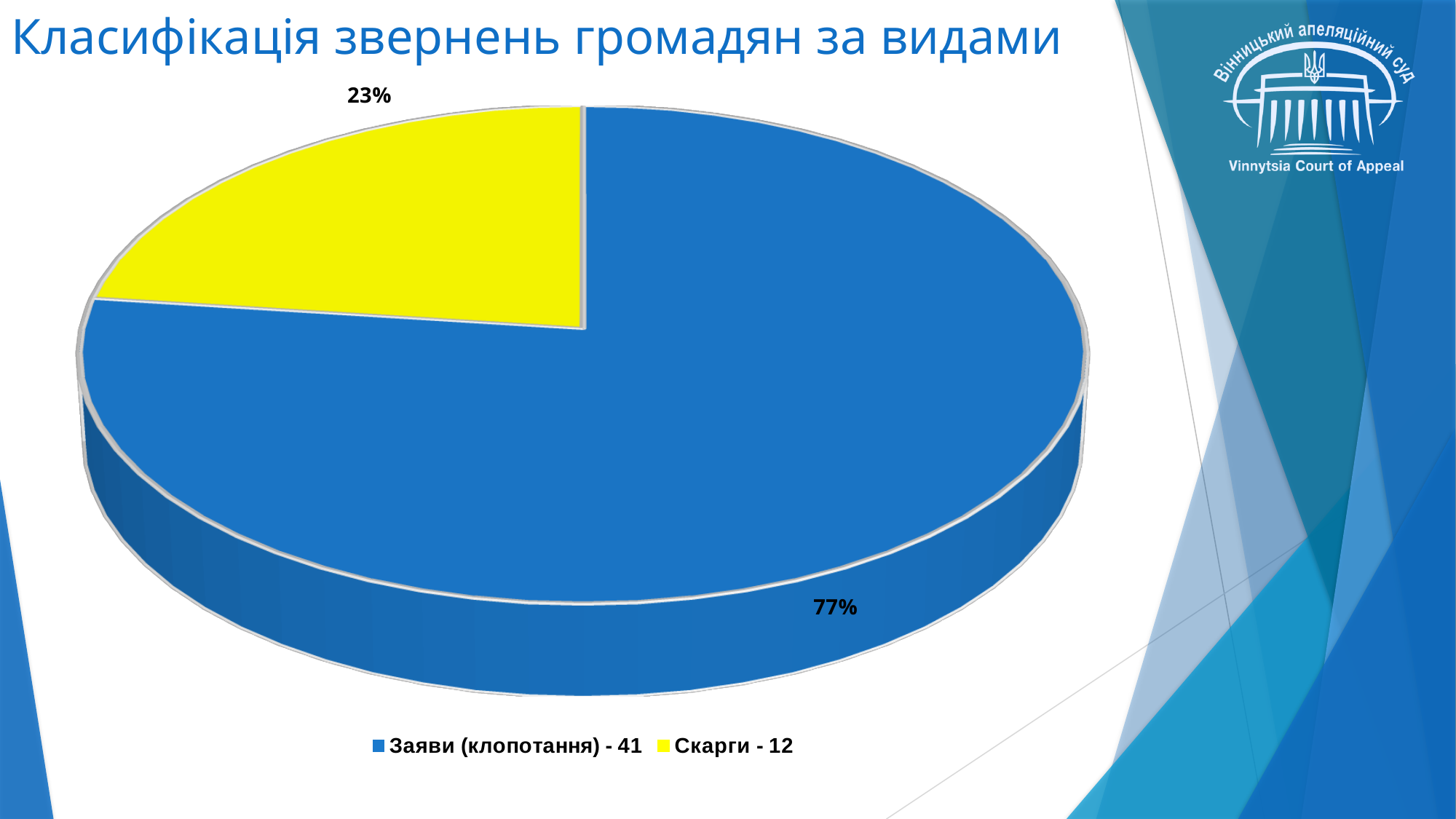
How many entries does the legend list? 2 Which slice is larger: "Заяви (клопотання)" or "Скарги"? Заяви (клопотання) What is the difference in percentage points between the "Заяви (клопотання)" slice and the "Скарги" slice? 54 What colour is the slice for "Скарги - 12"? yellow How many categories does the pie chart show? 2 What is the title of the chart on the slide? Класифікація звернень громадян за видами Which category has the largest slice of the pie? Заяви (клопотання) - 41 What percentage share does the slice for "Заяви (клопотання) - 41" have? 77% Which category has the smallest slice of the pie? Скарги - 12 What is the total count of appeals shown in the legend (41 + 12)? 53 What percentage share does the slice for "Скарги - 12" have? 23% What kind of chart is shown on the slide? pie chart